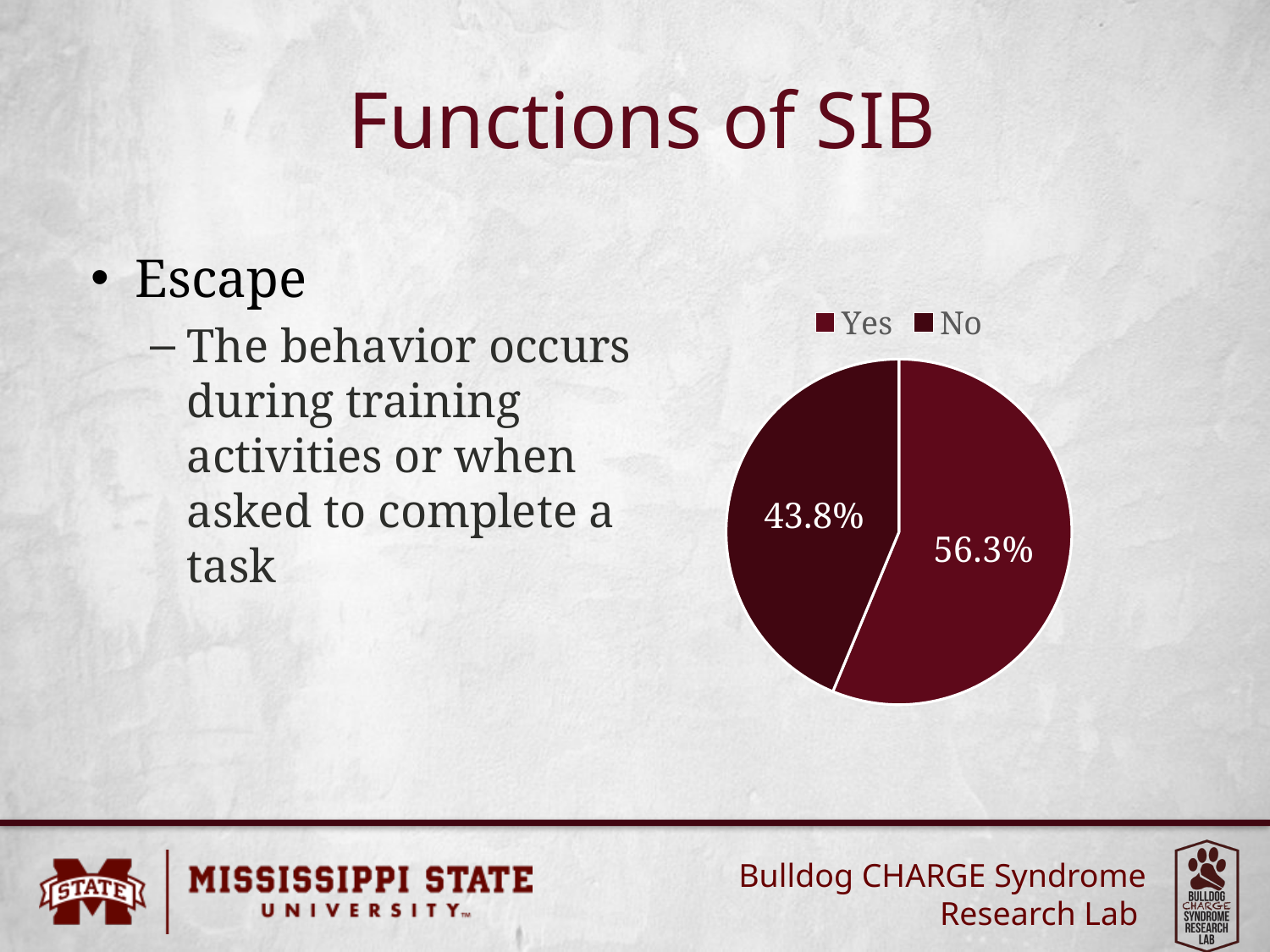
What are the two legend entries of the pie chart? Yes and No What percentage of the pie is labelled for the "Yes" slice? 56.3% Which slice of the pie chart is the smallest? No Is the "Yes" slice greater or less than 50% of the pie? greater Which slice of the pie chart is the largest? Yes What kind of chart is shown on the slide? pie chart Which is larger in the pie chart, the "Yes" slice or the "No" slice? Yes How many entries does the legend of the pie chart list? 2 What is the difference in percentage points between the "Yes" and "No" slices? 12.5 What percentage of the pie is labelled for the "No" slice? 43.8% What is the title of the slide containing the pie chart? Functions of SIB How many slices does the pie chart have? 2